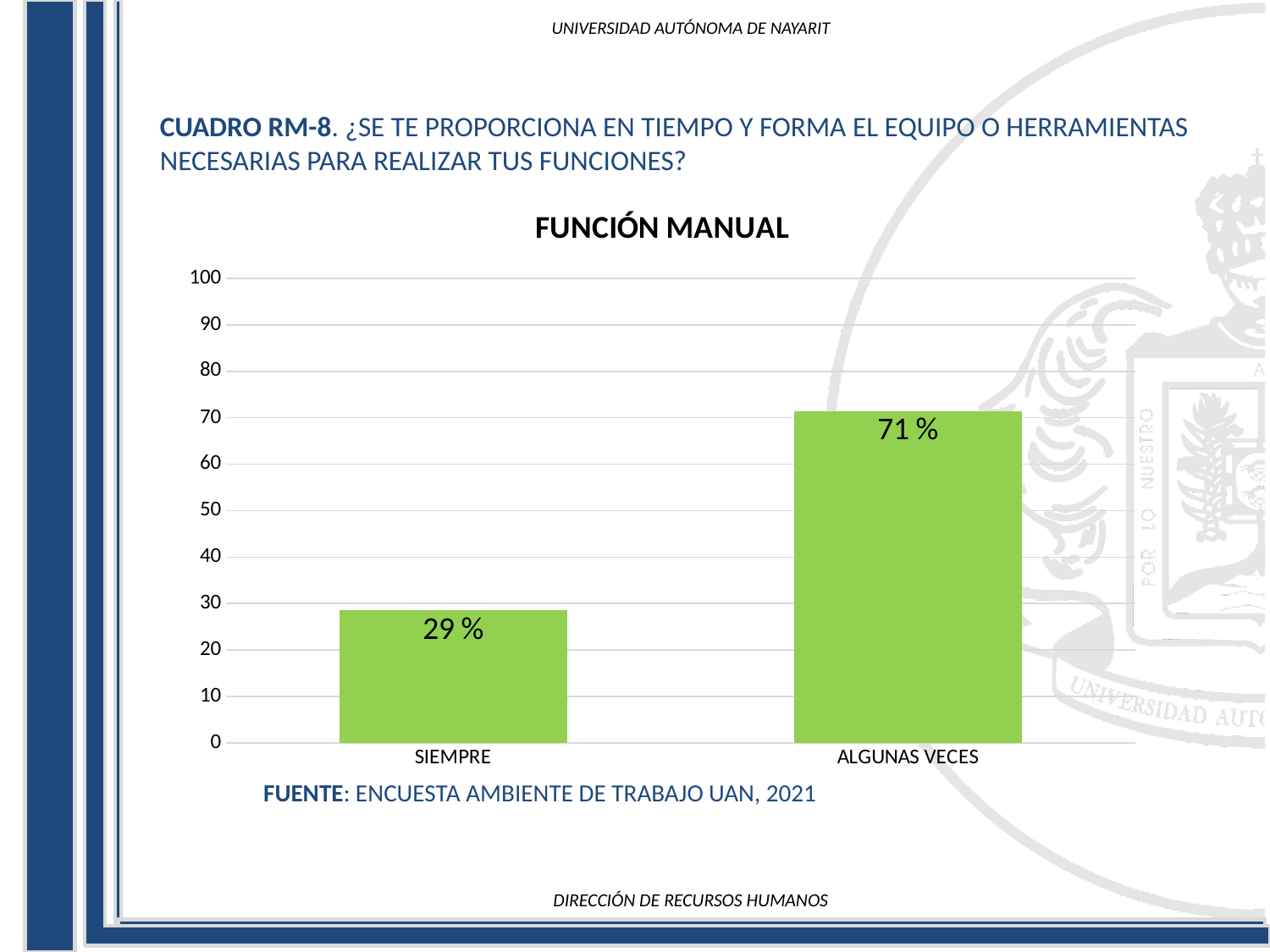
What is the value for ALGUNAS VECES? 71 % What is the title of the chart? FUNCIÓN MANUAL Which category has the highest value? ALGUNAS VECES How many categories are shown on the x axis? 2 Is the value for ALGUNAS VECES greater or less than 70? greater What colour are the bars in the chart? green What kind of chart is shown on the slide? bar chart What is the value for SIEMPRE? 29 % Which category has the lowest value? SIEMPRE What is the difference between the values for ALGUNAS VECES and SIEMPRE? 42 % Which is larger, the value for SIEMPRE or the value for ALGUNAS VECES? ALGUNAS VECES Is the value for SIEMPRE greater or less than 30? less